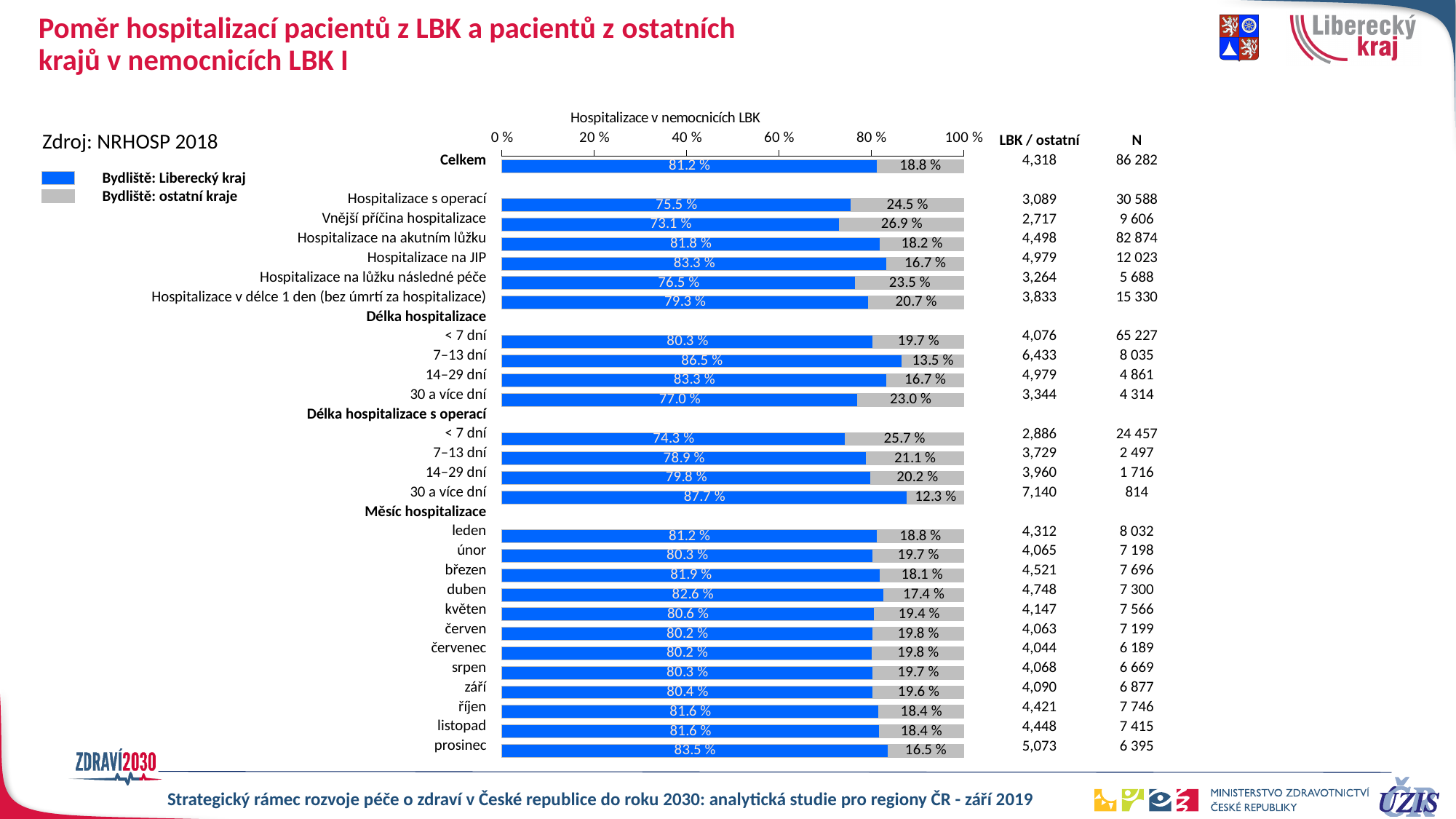
What is the share of 'Bydliště: ostatní kraje' for 'Hospitalizace na JIP'? 16.7 % How many months are listed under 'Měsíc hospitalizace'? 12 What is the 'Bydliště: ostatní kraje' share for the month 'prosinec'? 16.5 % Is the 'Bydliště: Liberecký kraj' share for 'Vnější příčina hospitalizace' greater or less than 80 %? less What percentage of hospitalisations in the 'Celkem' row are for patients with residence in Liberecký kraj? 81.2 % What is the difference in percentage points between the Liberecký kraj share and the ostatní kraje share for 'Hospitalizace s operací'? 51.0 percentage points What kind of chart is shown on the slide? Stacked horizontal bar chart Which has a larger 'Bydliště: Liberecký kraj' share: 'Hospitalizace na JIP' or 'Hospitalizace na lůžku následné péče'? Hospitalizace na JIP Which category has the highest share of 'Bydliště: Liberecký kraj'? 30 a více dní (Délka hospitalizace s operací), 87.7 % How many series does the legend list? 2 Which category has the lowest share of 'Bydliště: Liberecký kraj'? Vnější příčina hospitalizace, 73.1 % What is the total of the stacked bar for 'Celkem'? 100 %